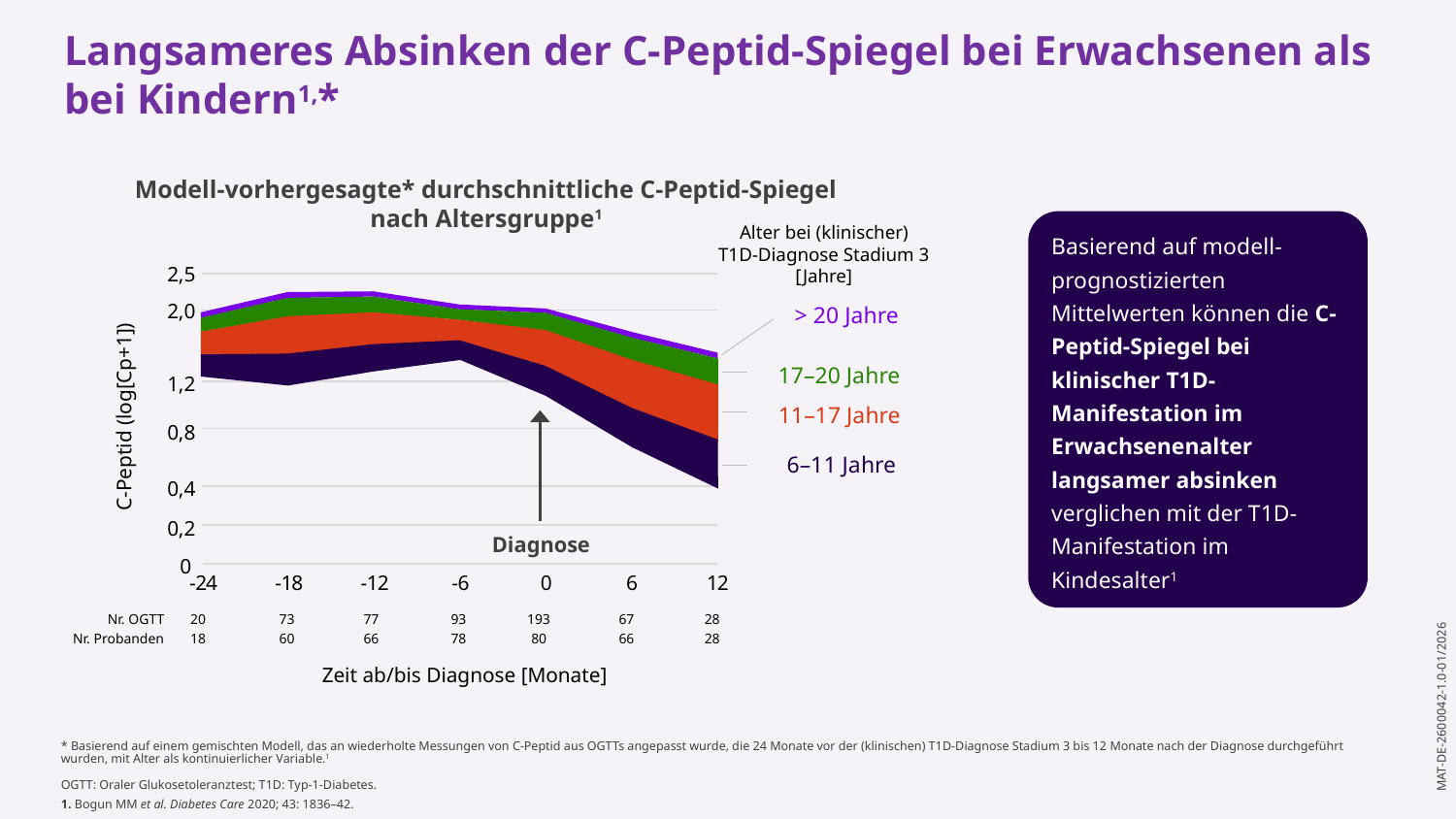
Is the value for the > 20 Jahre group at 12 months greater or less than 1.2? greater What event does the vertical arrow at month 0 mark on the chart? Diagnose Is the value for the 6–11 Jahre group at 12 months greater or less than 0.8? less What is the difference between the number of OGTTs at month 0 and at month 6? 126 What kind of chart is shown on the slide? Area chart How many time points are shown on the x axis of the chart? 7 What is the number of OGTTs (Nr. OGTT) at month 0 in the table below the chart? 193 Do the C-peptide values for the 6–11 Jahre group rise or fall between month 0 and month 12? fall At which time point is the number of OGTTs (Nr. OGTT) highest? 0 At 12 months after diagnosis, which group has the higher C-peptide value: > 20 Jahre or 6–11 Jahre? > 20 Jahre Which age group is shown in purple at the top of the chart? > 20 Jahre How many age groups does the legend of the chart list? 4